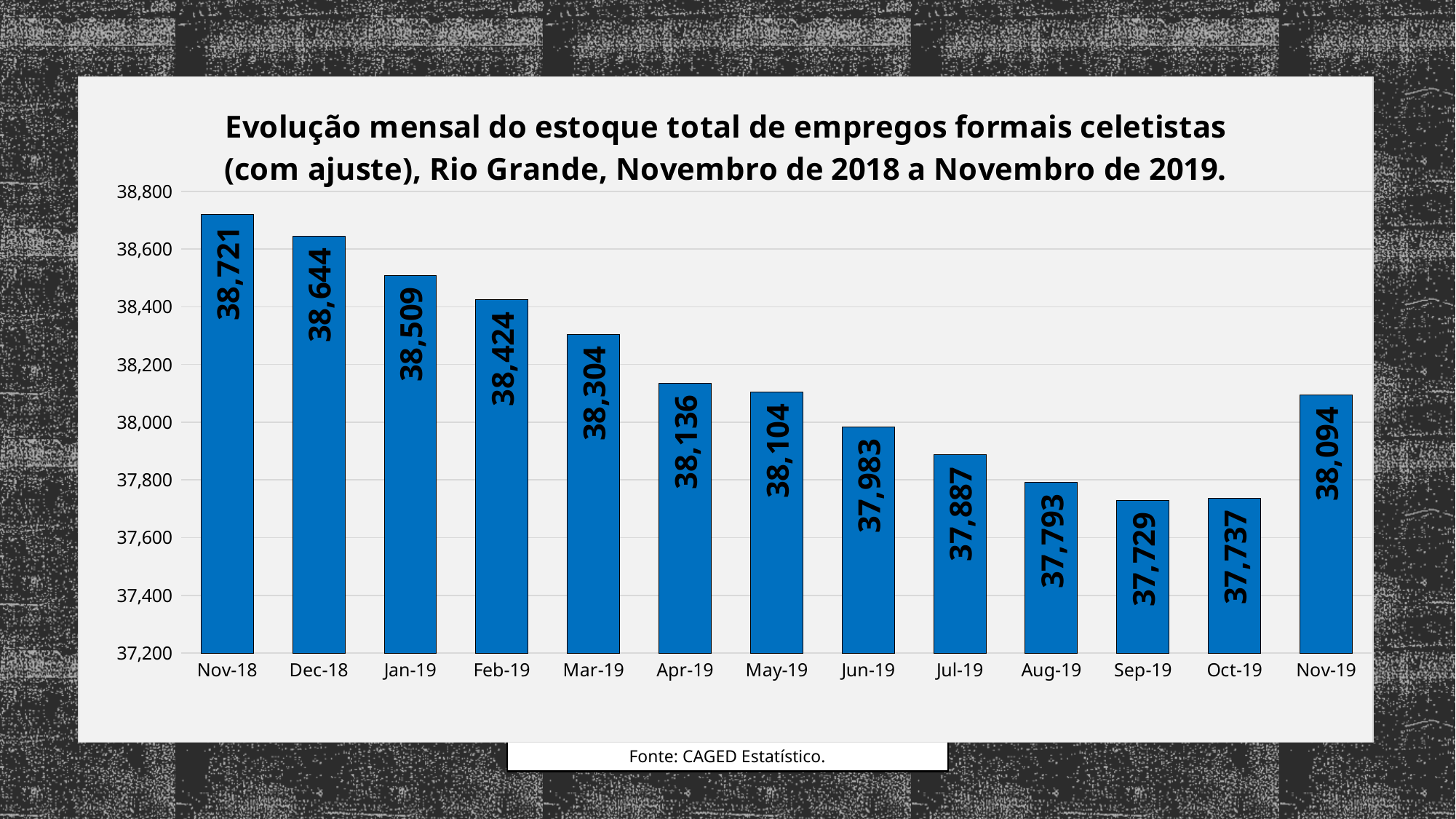
How many months are shown on the x axis? 13 Which month has the highest value? Nov-18 Is the value for Jun-19 greater or less than 38,000? less What kind of chart is this? bar chart Which is larger, the value for Apr-19 or the value for May-19? Apr-19 Which month has the lowest value? Sep-19 What is the value for Nov-18? 38,721 What is the value for Nov-19? 38,094 Do the values rise or fall from Nov-18 to Sep-19? fall What is the difference between the values for Nov-18 and Nov-19? 627 What is the difference between the values for Oct-19 and Nov-19? 357 What is the value for Sep-19? 37,729